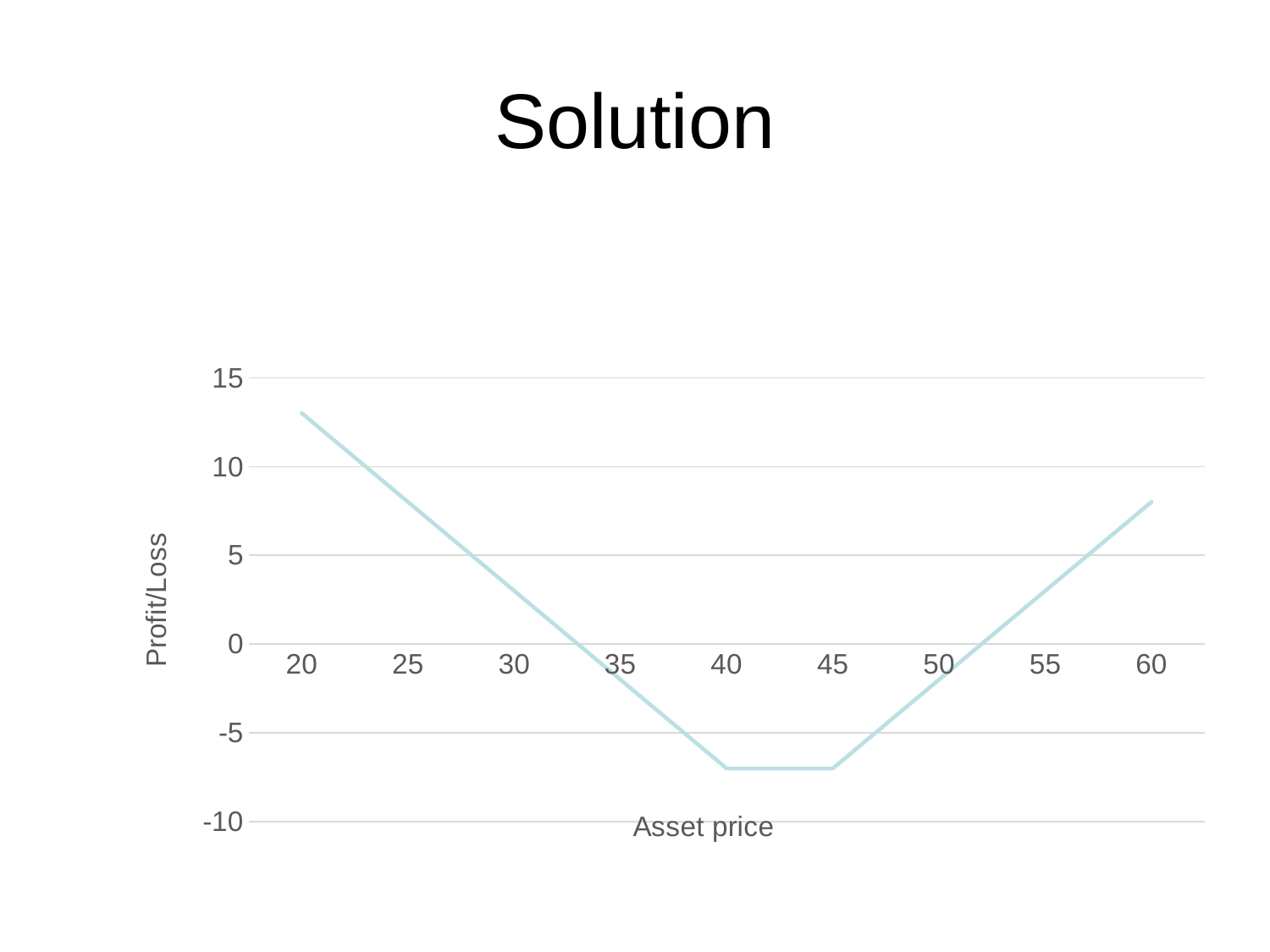
Is the profit/loss at asset price 55 greater or less than 0? greater What kind of chart is shown on the slide? line chart Which has the larger profit/loss: asset price 30 or asset price 35? 30 Is the profit/loss at asset price 60 greater or less than 10? less Which has the larger profit/loss: asset price 20 or asset price 60? 20 What is the label of the vertical axis? Profit/Loss How many asset price points are plotted on the x axis? 9 Is the profit/loss at asset price 35 greater or less than 0? less At which asset price is the profit/loss highest? 20 Does the profit/loss rise or fall as the asset price goes from 20 to 40? fall